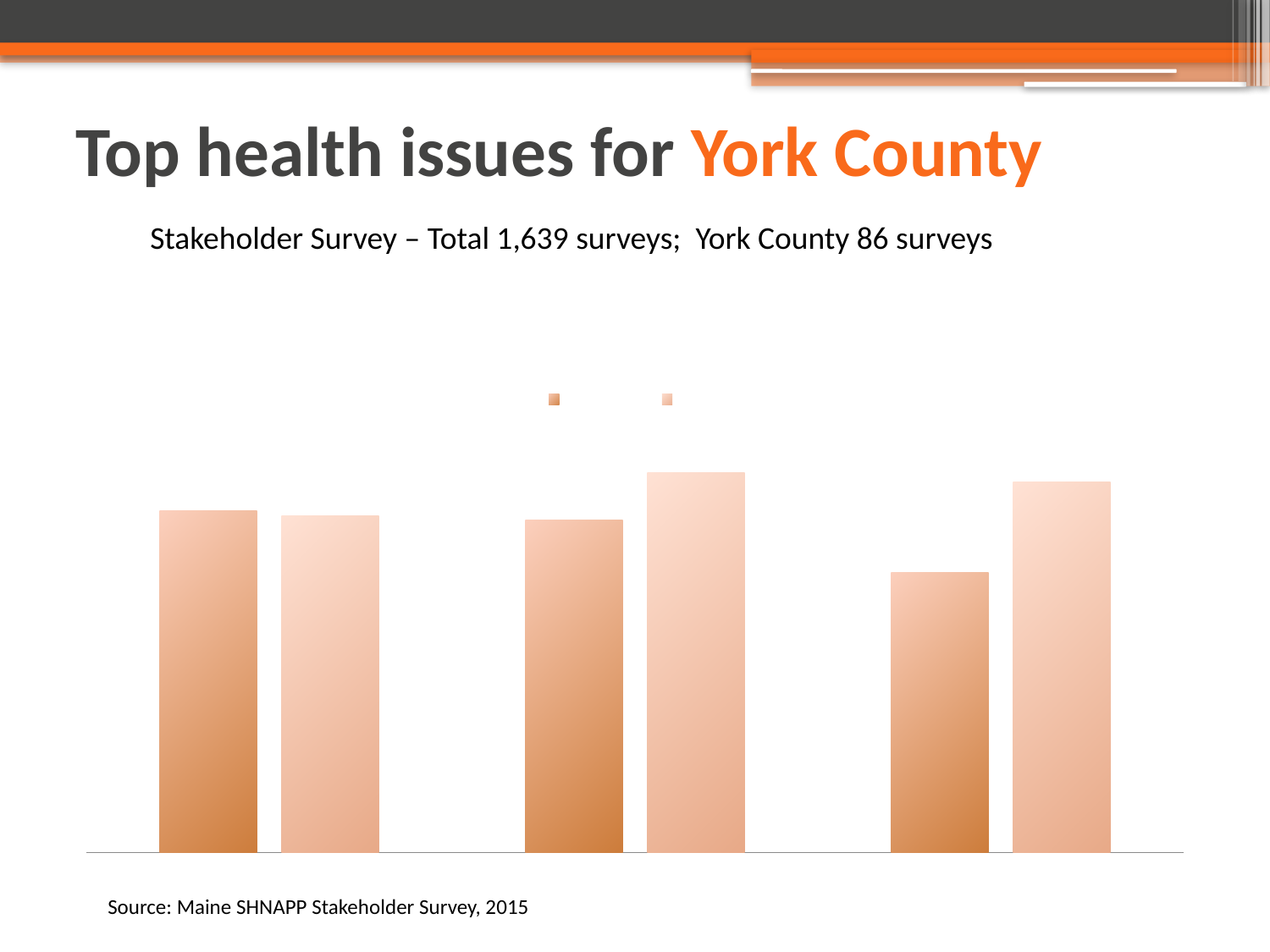
What is the title of the slide containing the chart? Top health issues for York County Which bar is the tallest on the chart? the lighter bar in the middle group Among the darker bars, which group has the shortest one? the rightmost group Which bar is the shortest on the chart? the darker bar in the rightmost group In the rightmost group of bars, is the darker bar or the lighter bar taller? the lighter bar What kind of chart is shown on the slide? bar chart In the middle group of bars, is the darker bar or the lighter bar taller? the lighter bar What source is cited below the chart? Maine SHNAPP Stakeholder Survey, 2015 How many groups of bars does the chart show? 3 How many series does the chart's legend list? 2